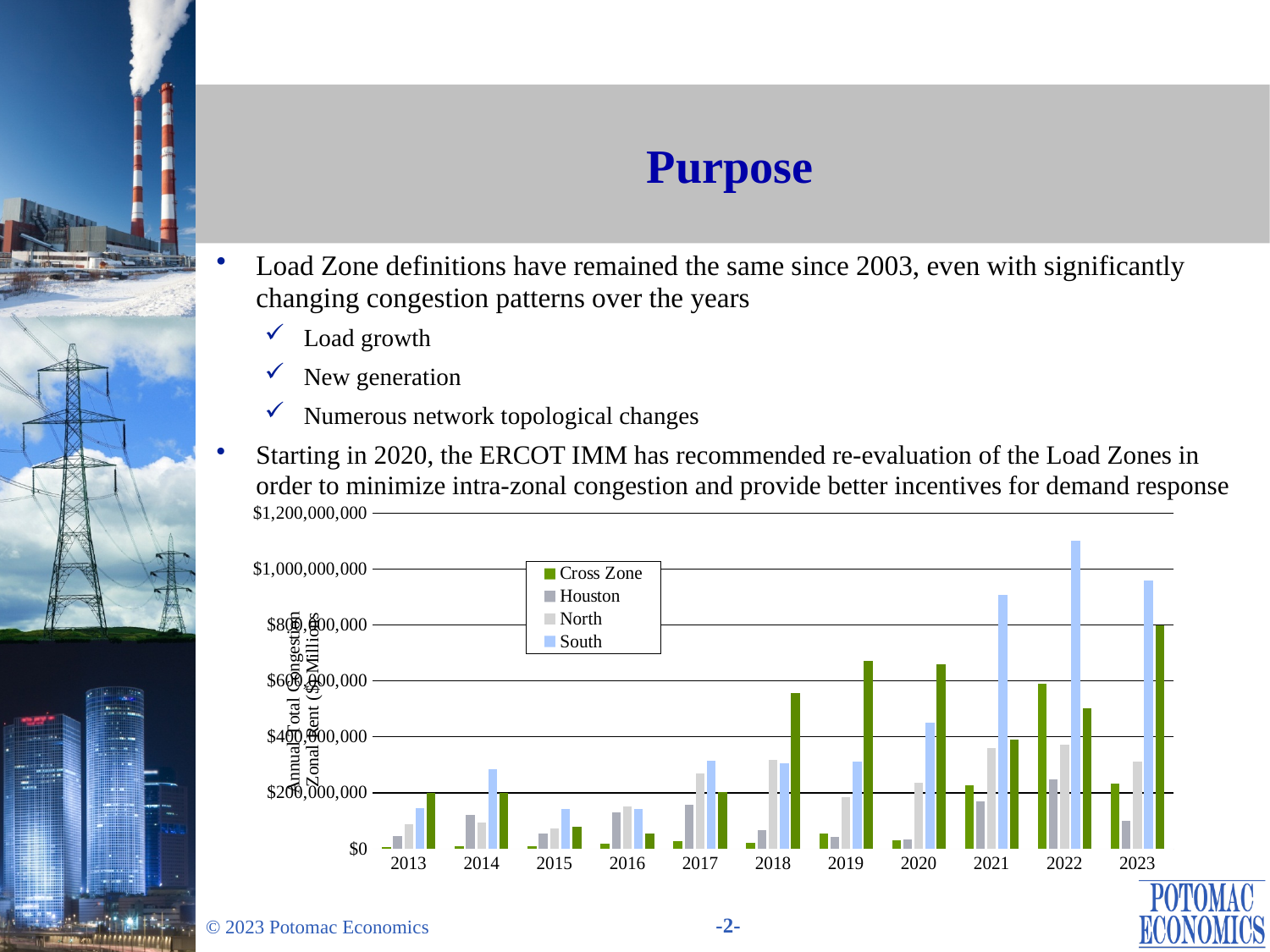
Is the Houston value for 2013 greater or less than $200,000,000? less In which year is the South bar the highest? 2022 Which is larger, the Cross Zone value for 2019 or the Cross Zone value for 2018? 2019 Which series is shown in green in the chart's legend? Cross Zone Is the South value for 2021 greater or less than $800,000,000? greater What kind of chart is shown on the slide? bar chart Is the Cross Zone value for 2018 greater or less than $600,000,000? less Which is larger, the South value for 2022 or the South value for 2021? 2022 How many series does the chart's legend list? 4 How many years are shown along the x axis of the chart? 11 Which series has the tallest bar in the entire chart? South